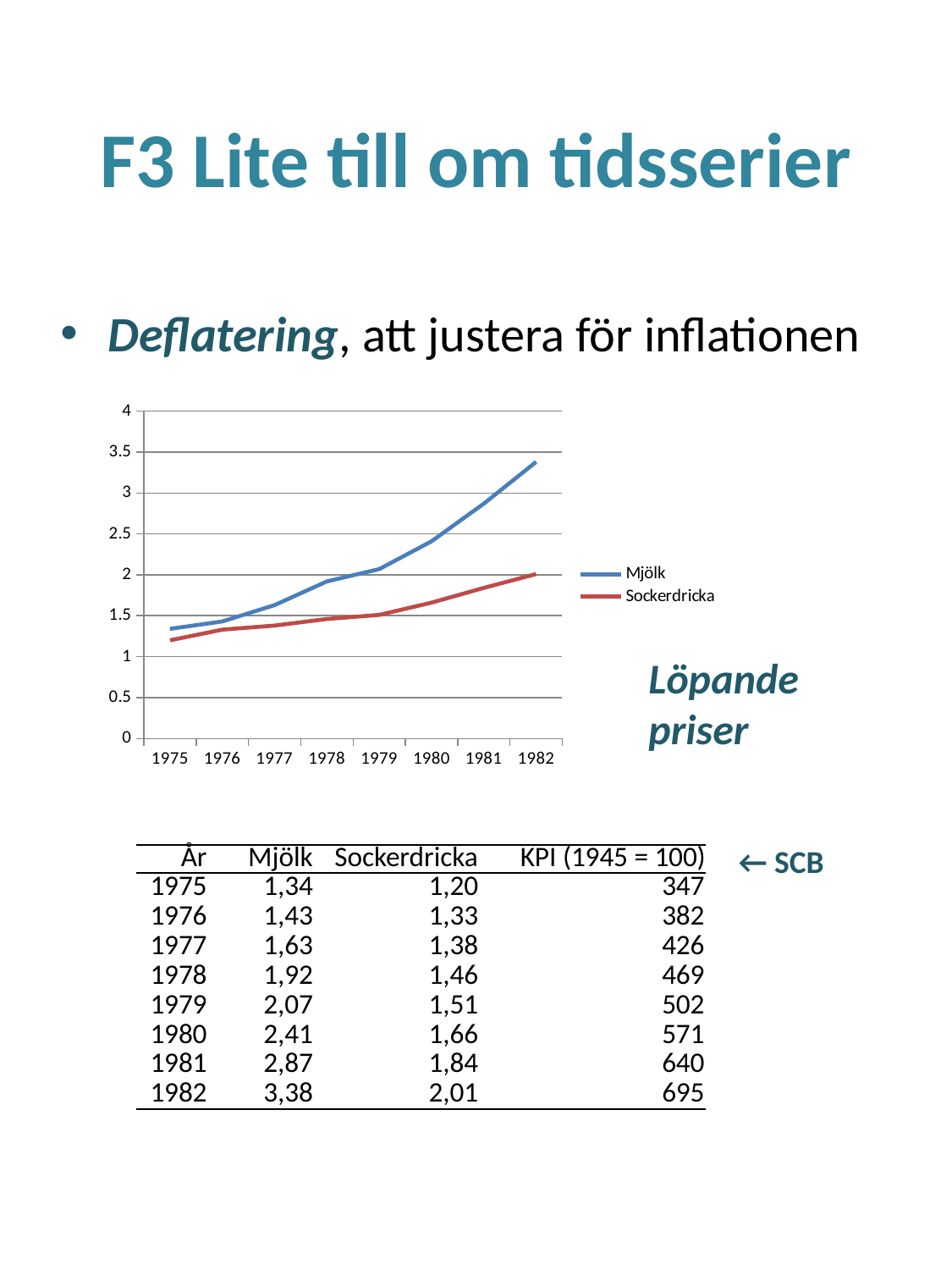
Is the value for Sockerdricka in 1979 greater or less than 2? less How many years are plotted along the x axis of the chart? 8 Does the Mjölk line rise or fall from 1975 to 1982? rises In which year does the Sockerdricka series have its lowest value? 1975 How many series does the chart's legend list? 2 What kind of chart is shown on the slide? line chart Which series is plotted with the blue line? Mjölk In 1982, which series has the higher value, Mjölk or Sockerdricka? Mjölk According to the table on the slide, what is the value for Mjölk in 1980? 2,41 According to the table on the slide, what is the difference between the Mjölk and Sockerdricka values in 1982? 1,37 Is the value for Mjölk in 1982 greater or less than 3? greater In which year does the Mjölk series reach its highest value? 1982